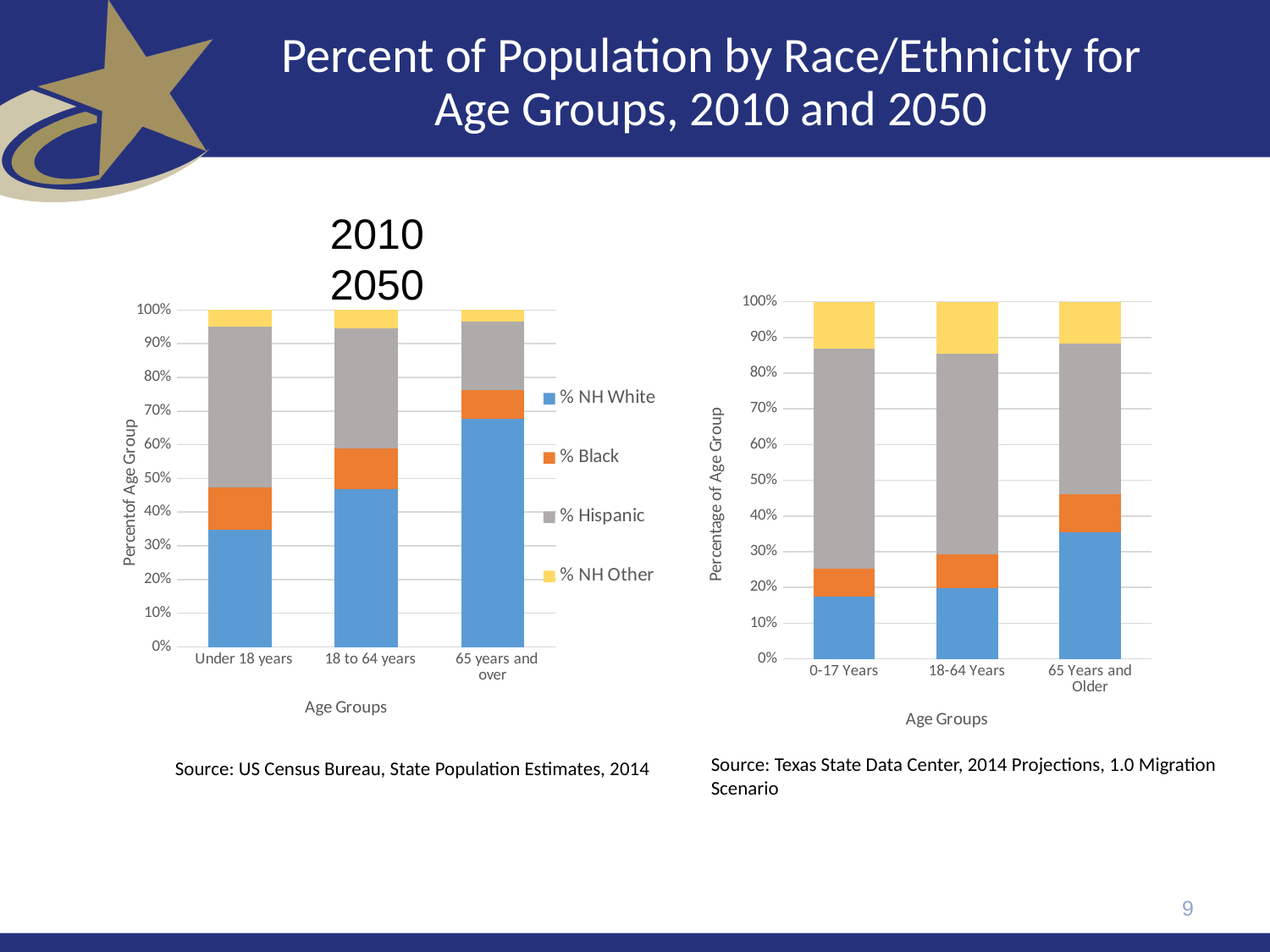
In the left chart (2010), is the % NH White segment larger for 18 to 64 years or for Under 18 years? 18 to 64 years In the right chart (2050), is the bottom blue segment for 65 Years and Older greater or less than 30%? greater In the left chart (2010), which age group has the largest % NH White segment? 65 years and over What kind of chart is the left chart (2010)? Stacked bar chart How many series does the legend of the left chart (2010) list? 4 In the right chart (2050), which age group has the largest bottom blue segment? 65 Years and Older How many age groups are shown on the x axis of the left chart (2010)? 3 In the left chart (2010), is the % NH White value for Under 18 years greater or less than 40%? less What is the x-axis title of the left chart (2010)? Age Groups How many age groups are shown on the x axis of the right chart (2050)? 3 In the left chart (2010), is the % NH White value for 65 years and over greater or less than 60%? greater In the left chart (2010), which age group has the largest % Hispanic segment? Under 18 years